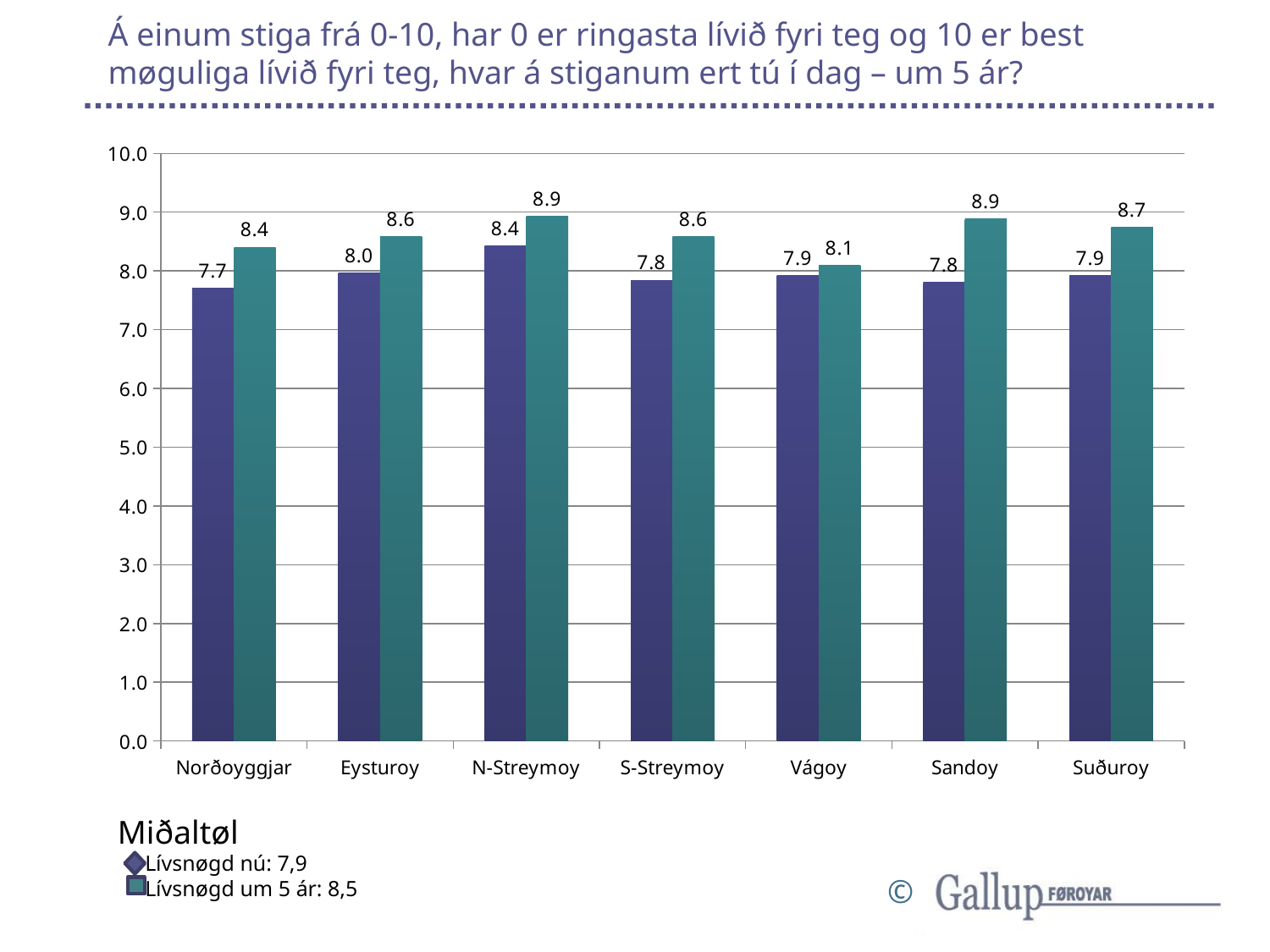
How many regions are shown on the x axis of the chart? 7 What average (Miðaltøl) is given in the legend for "Lívsnøgd um 5 ár"? 8,5 What is the value of the "Lívsnøgd nú" bar for Eysturoy? 8.0 Which region has the lowest "Lívsnøgd nú" value? Norðoyggjar Which region has the highest "Lívsnøgd nú" value? N-Streymoy Which region has the lowest "Lívsnøgd um 5 ár" value? Vágoy What kind of chart is shown on the slide? Bar chart Which is larger for Vágoy: the "Lívsnøgd nú" value or the "Lívsnøgd um 5 ár" value? Lívsnøgd um 5 ár How many series does the chart's legend list? 2 What is the value of the "Lívsnøgd nú" bar for Norðoyggjar? 7.7 What is the value of the "Lívsnøgd um 5 ár" bar for Sandoy? 8.9 What is the difference between the "Lívsnøgd um 5 ár" and "Lívsnøgd nú" values for Sandoy? 1.1